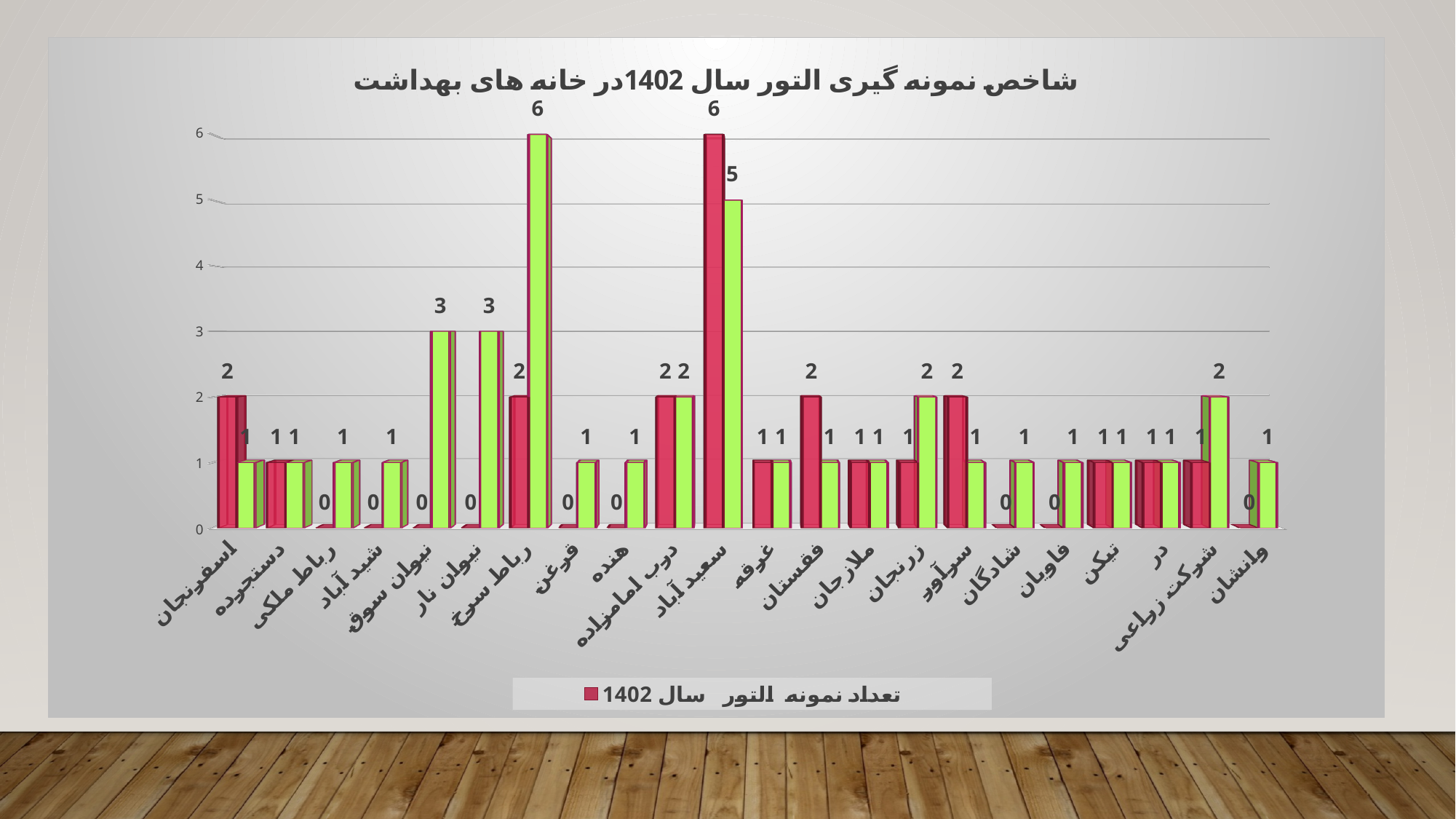
Which category has the highest value for the red series (تعداد نمونه التور سال 1402)? سعید آباد What is the value of the red bar (تعداد نمونه التور سال 1402) for سعید آباد? 6 How many categories are shown on the x axis? 22 Which category has the highest green bar? رباط سرخ Which is larger, the red bar for اسفرنجان or the red bar for دستجرده? اسفرنجان How many series does the legend list? 1 What is the value of the green bar for نیوان سوق? 3 What is the difference between the red bar and the green bar for سعید آباد? 1 What is the value of the green bar for رباط سرخ? 6 What is the difference between the green bar and the red bar for رباط سرخ? 4 What kind of chart is shown on the slide? Bar chart What is the value of the red bar (تعداد نمونه التور سال 1402) for اسفرنجان? 2